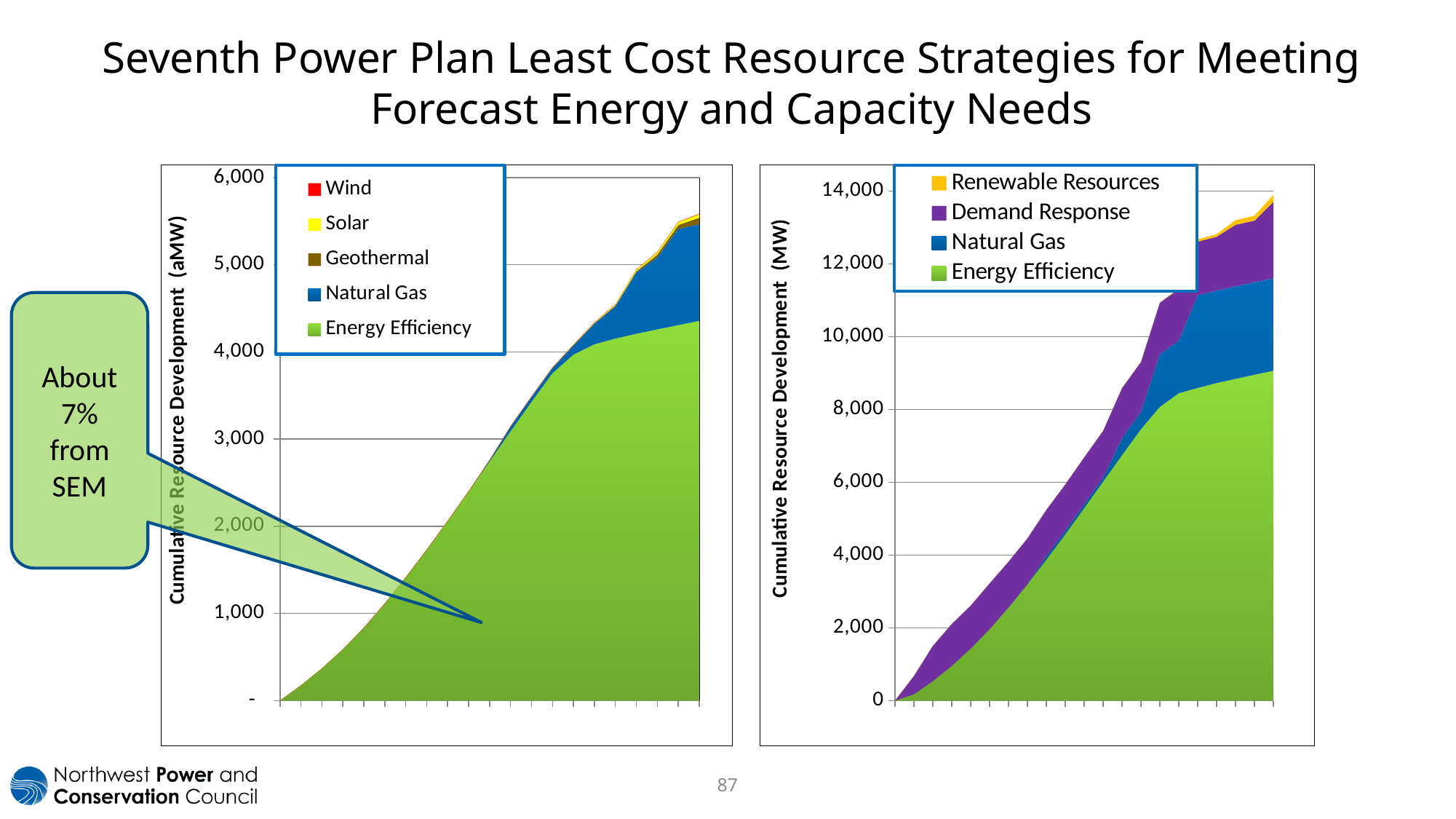
In the right chart, do the cumulative values rise or fall along the x axis? Rise What kind of chart is the left chart on the slide? Stacked area chart What kind of chart is the right chart on the slide? Stacked area chart In the left chart, do the cumulative values rise or fall along the x axis? Rise What is the y-axis label of the right chart? Cumulative Resource Development (MW) How many series does the legend of the right chart list? 4 In the right chart, is the total stacked value at the right end of the x axis greater or less than 12,000? greater Which series occupies the largest area in the right chart? Energy Efficiency In the left chart, is the Energy Efficiency value at the right end of the x axis greater or less than 4,000? greater How many series does the legend of the left chart list? 5 In the left chart, is the total stacked value at the right end of the x axis greater or less than 5,000? greater